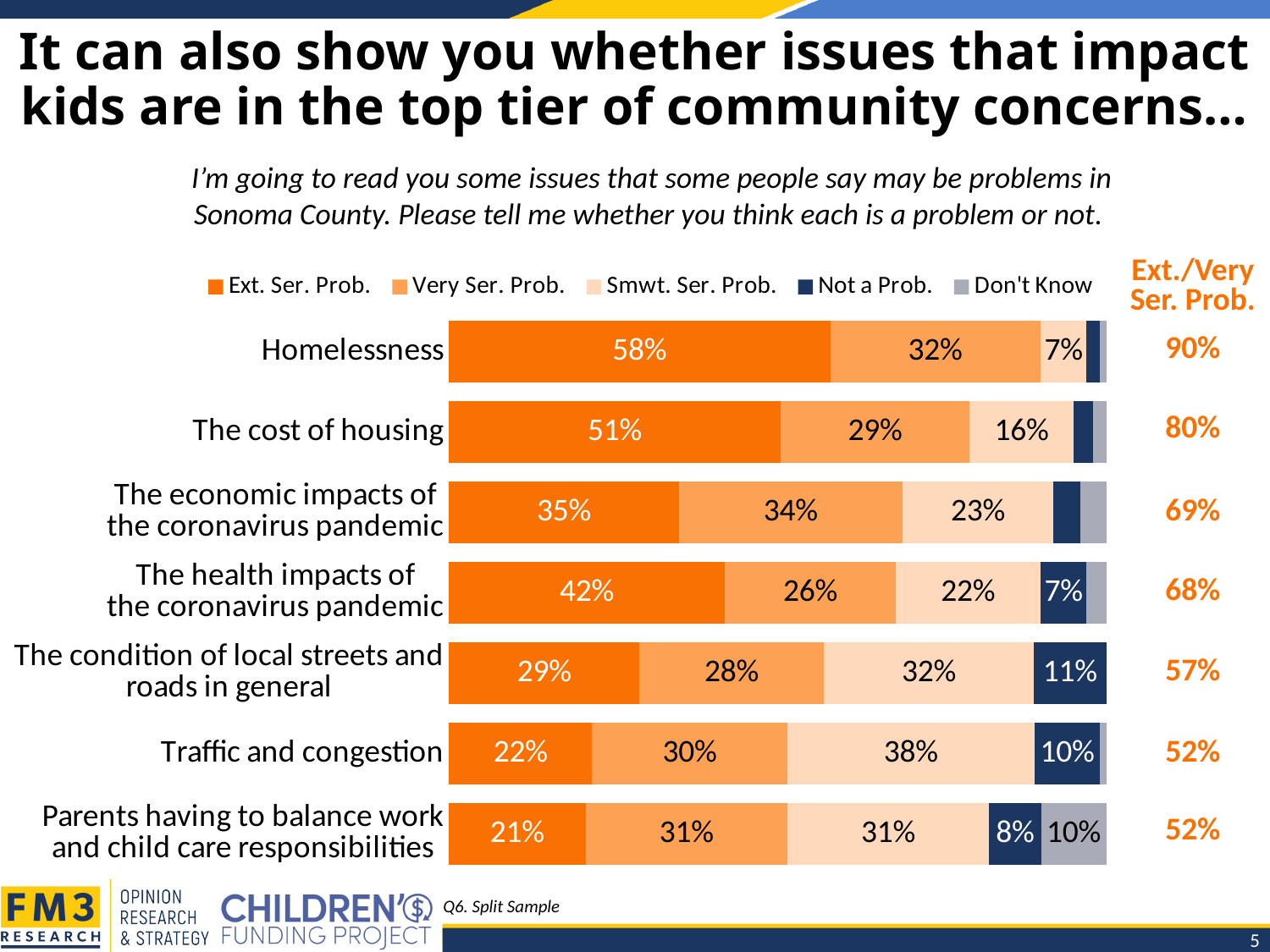
What is the Don't Know value for Parents having to balance work and child care responsibilities? 10% What is the Not a Prob. value for The condition of local streets and roads in general? 11% What is the Smwt. Ser. Prob. value for Traffic and congestion? 38% How many issues (categories) are plotted in the chart? 7 What is the Very Ser. Prob. value for The cost of housing? 29% What percentage of respondents said Homelessness is an extremely serious problem (Ext. Ser. Prob.)? 58% Which issue has the lowest Ext. Ser. Prob. percentage? Parents having to balance work and child care responsibilities How many series does the legend list? 5 What is the difference between the Ext. Ser. Prob. values for Homelessness and The cost of housing? 7 percentage points Which is larger: the Ext. Ser. Prob. value for The health impacts of the coronavirus pandemic or for The economic impacts of the coronavirus pandemic? The health impacts of the coronavirus pandemic Which issue has the highest combined Ext./Very Ser. Prob. percentage? Homelessness What kind of chart is shown on the slide? Stacked bar chart